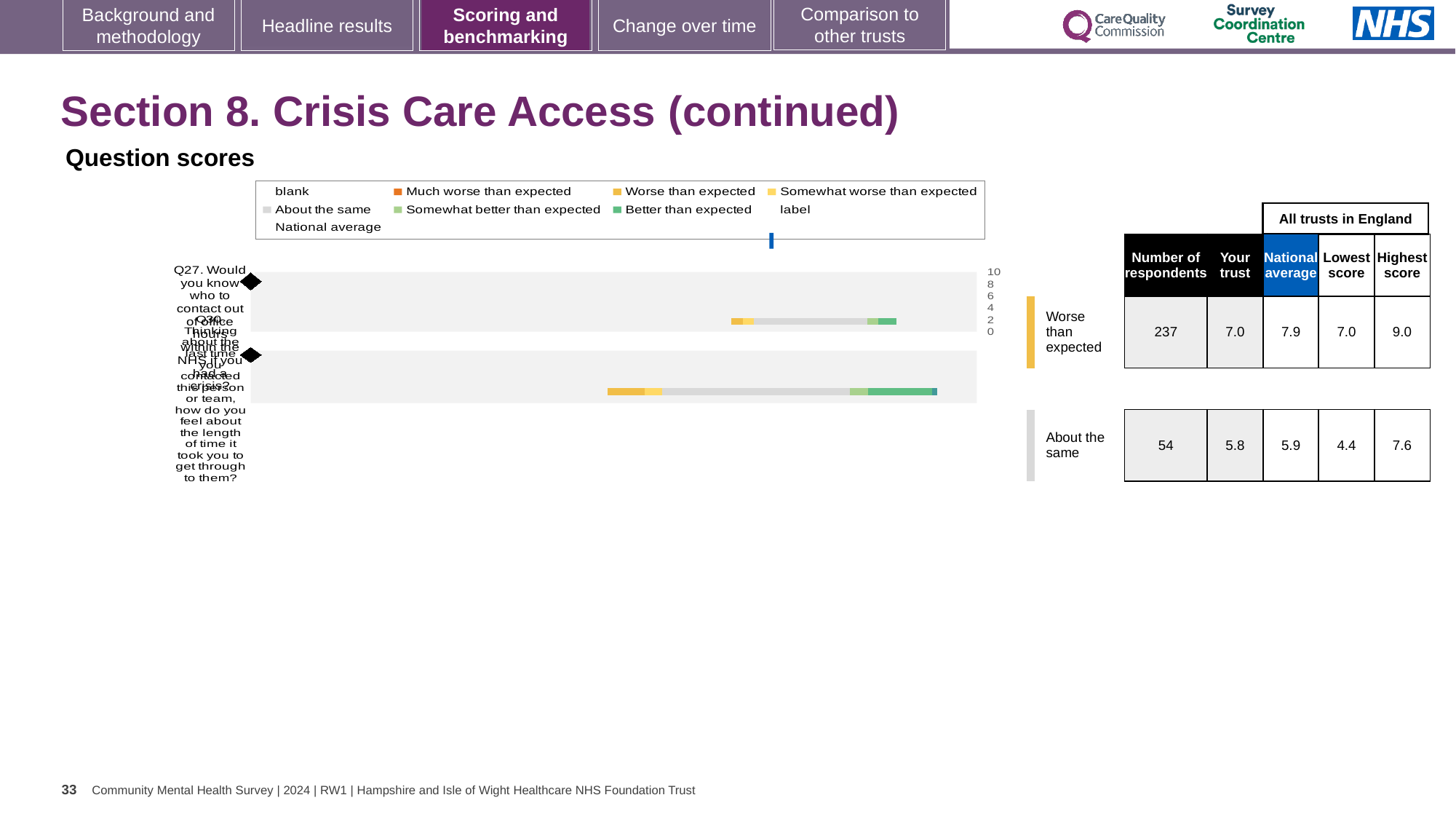
What kind of chart is used to show the question scores on this slide? bar chart What is the highest score among all trusts in England for Q30? 7.6 How is the trust's result for Q30 categorised relative to expectation? About the same What is the 'Your trust' score for Q27? 7.0 How many more respondents answered Q27 than Q30? 183 Which question has more respondents, Q27 or Q30? Q27 How many questions (categories) are plotted in the question scores chart? 2 What is the lowest score among all trusts in England for Q27? 7.0 How many respondents answered Q27? 237 How is the trust's result for Q27 categorised relative to expectation? Worse than expected What is the national average score for Q30? 5.9 What is the difference between the highest and lowest trust scores for Q27? 2.0